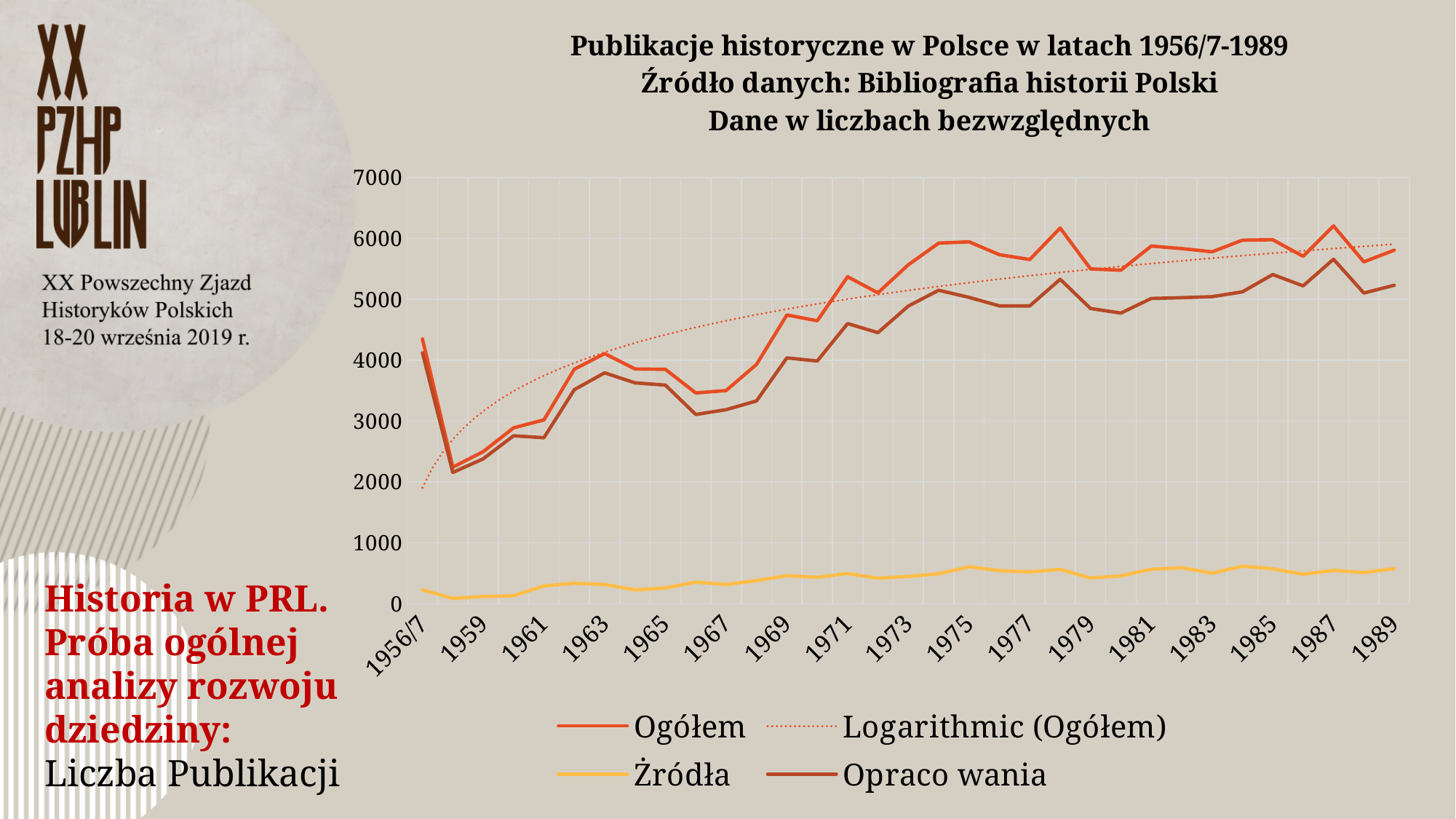
How many series does the legend list? 4 Does the Ogółem series generally rise or fall from 1959 to 1989? rise Is the value for Opracowania in 1989 greater or less than 4000? greater What is the data source named in the chart title? Bibliografia historii Polski Which series has the highest values across the whole period? Ogółem In 1975, which is larger: Ogółem or Źródła? Ogółem Is the value for Ogółem in 1956/7 greater or less than 4000? greater Is the value for Źródła in 1989 greater or less than 1000? less In 1985, which is larger: Opracowania or Źródła? Opracowania Which series has the lowest values across the whole period? Źródła What kind of chart is shown on the slide? line chart